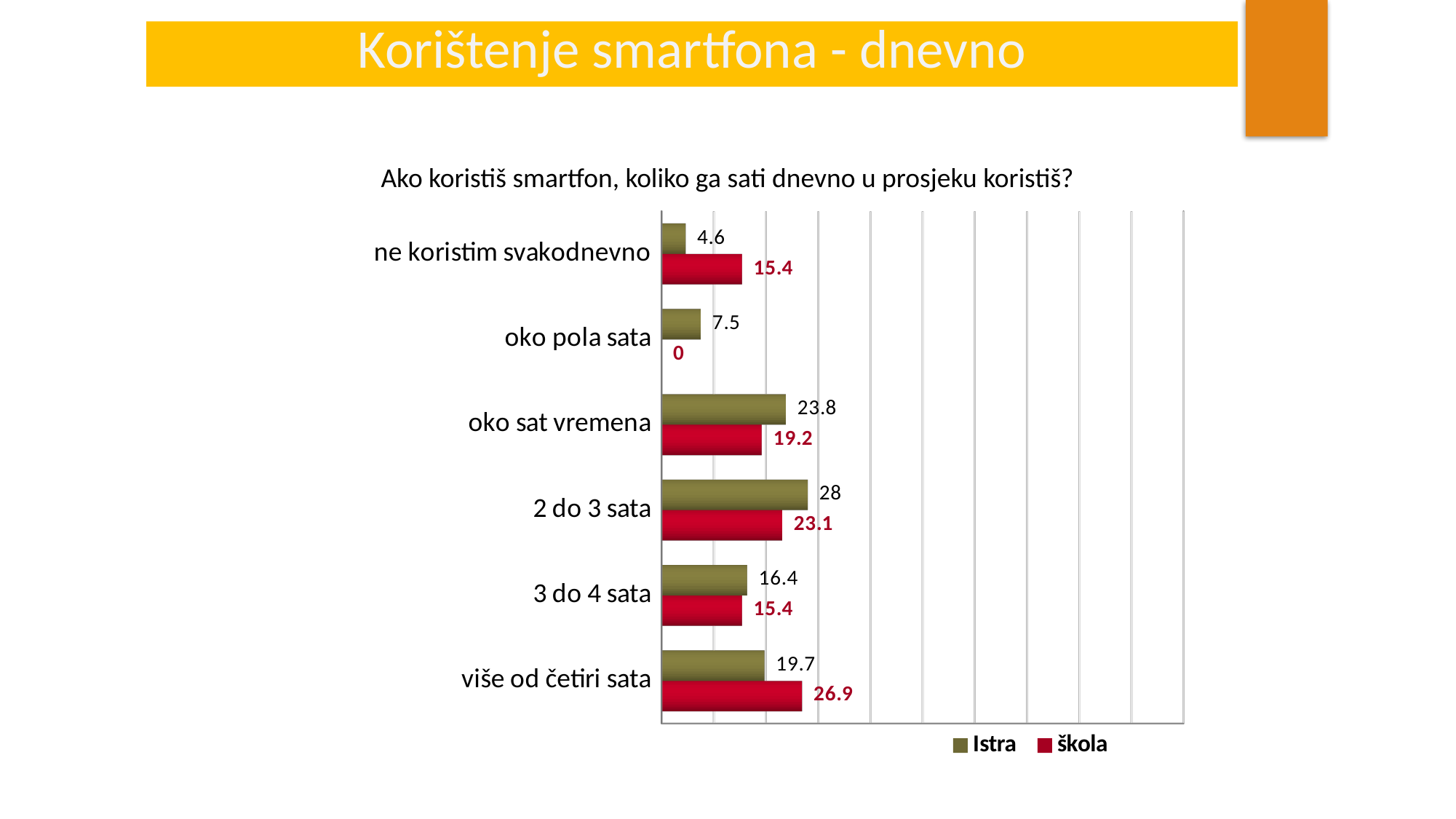
What is the value for Istra in the '2 do 3 sata' category? 28 What kind of chart is shown on the slide? bar chart What is the difference between the škola and Istra values for 'ne koristim svakodnevno'? 10.8 How many categories are shown on the chart? 6 Which series has the larger value for 'oko sat vremena', Istra or škola? Istra What is the value for škola in the 'oko pola sata' category? 0 What is the value for škola in the 'više od četiri sata' category? 26.9 What is the difference between the Istra and škola values for '2 do 3 sata'? 4.9 Which category has the highest value for the Istra series? 2 do 3 sata How many series does the legend list? 2 What is the title of the chart? Ako koristiš smartfon, koliko ga sati dnevno u prosjeku koristiš? Which category has the lowest value for the škola series? oko pola sata